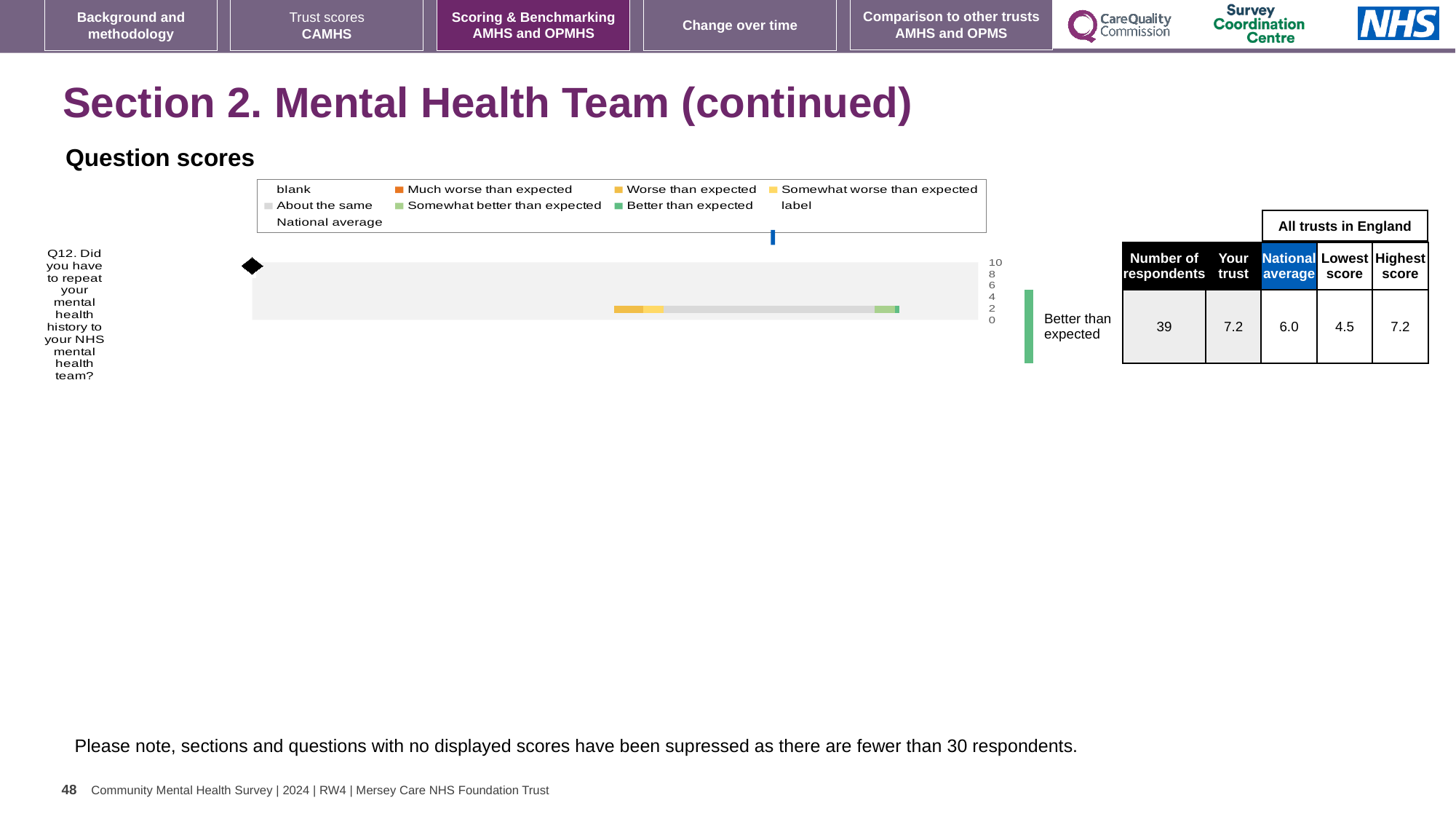
In the table beside the chart, what is the number of respondents for Q12? 39 In the table beside the chart, what is the national average score for Q12? 6.0 In the table beside the chart, which is larger for Q12: the 'Your trust' score or the national average? Your trust In the table beside the chart, what is the lowest score among all trusts in England for Q12? 4.5 In the table beside the chart, what is the highest score among all trusts in England for Q12? 7.2 What kind of chart is used to show the Q12 question score? bar chart What benchmark category label is shown to the right of the Q12 bar? Better than expected Which question is plotted in the Question scores chart? Q12. Did you have to repeat your mental health history to your NHS mental health team? In the table beside the chart, what is the 'Your trust' score for Q12? 7.2 How many survey questions are plotted in the Question scores chart? 1 In the table beside the chart, what is the difference between the 'Your trust' score and the national average for Q12? 1.2 What is the highest value shown on the chart's axis? 10